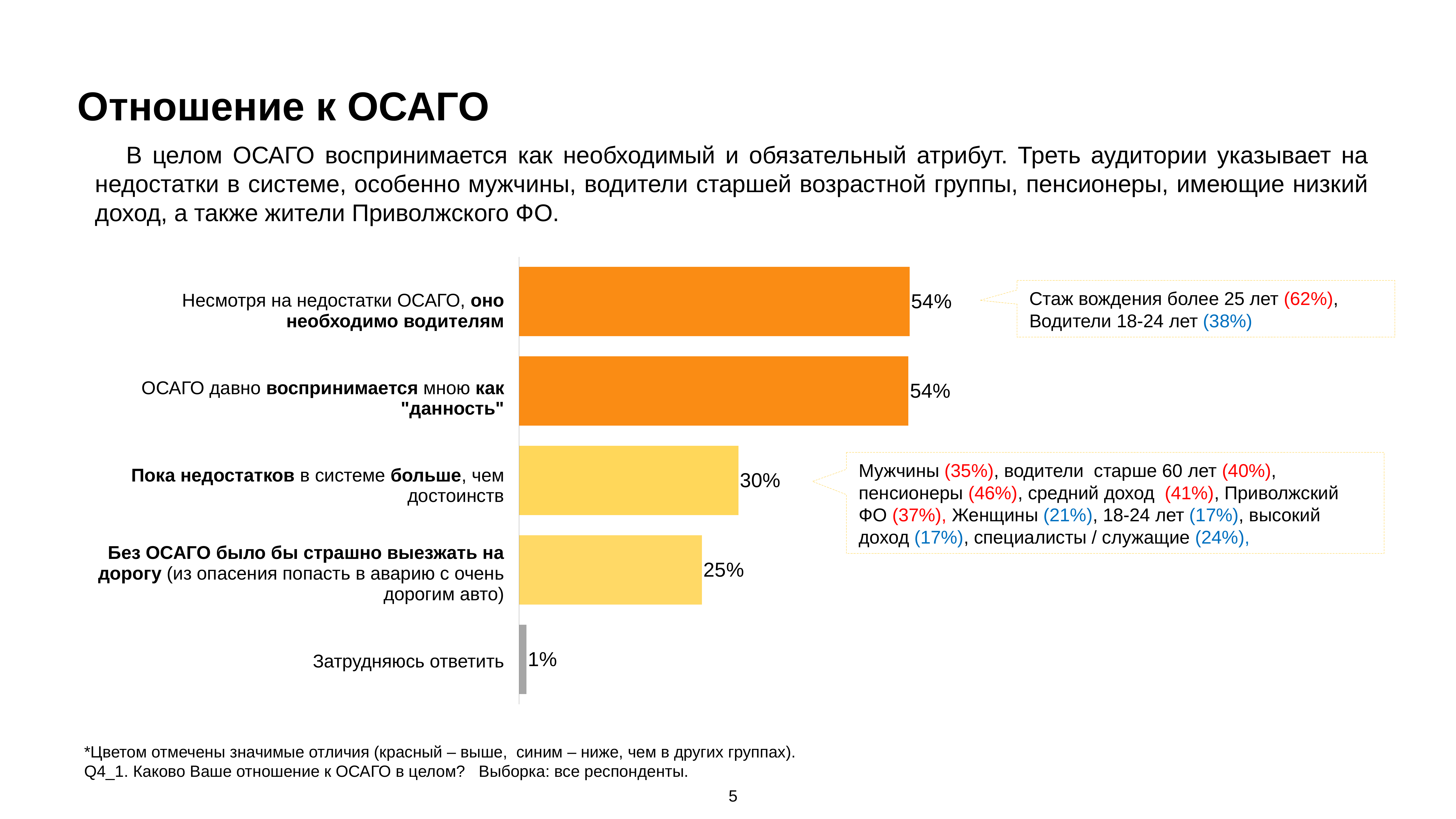
What is the difference between "Пока недостатков в системе больше, чем достоинств" and "Без ОСАГО было бы страшно выезжать на дорогу"? 5% What is the difference between "Несмотря на недостатки ОСАГО, оно необходимо водителям" and "Пока недостатков в системе больше, чем достоинств"? 24% Which category has the lowest value in the chart? Затрудняюсь ответить What percentage of respondents chose "Пока недостатков в системе больше, чем достоинств"? 30% What value is shown for "ОСАГО давно воспринимается мною как "данность""? 54% How many categories (bars) does the chart show? 5 Which is larger: the value for "Пока недостатков в системе больше, чем достоинств" or for "Без ОСАГО было бы страшно выезжать на дорогу"? Пока недостатков в системе больше, чем достоинств Do the values for "Несмотря на недостатки ОСАГО, оно необходимо водителям" and "ОСАГО давно воспринимается мною как "данность"" have the same value? Yes, both 54% What percentage is shown for "Затрудняюсь ответить"? 1% What colour is the bar for "Затрудняюсь ответить"? Grey What type of chart is shown on the slide? Bar chart What value is shown for "Без ОСАГО было бы страшно выезжать на дорогу"? 25%